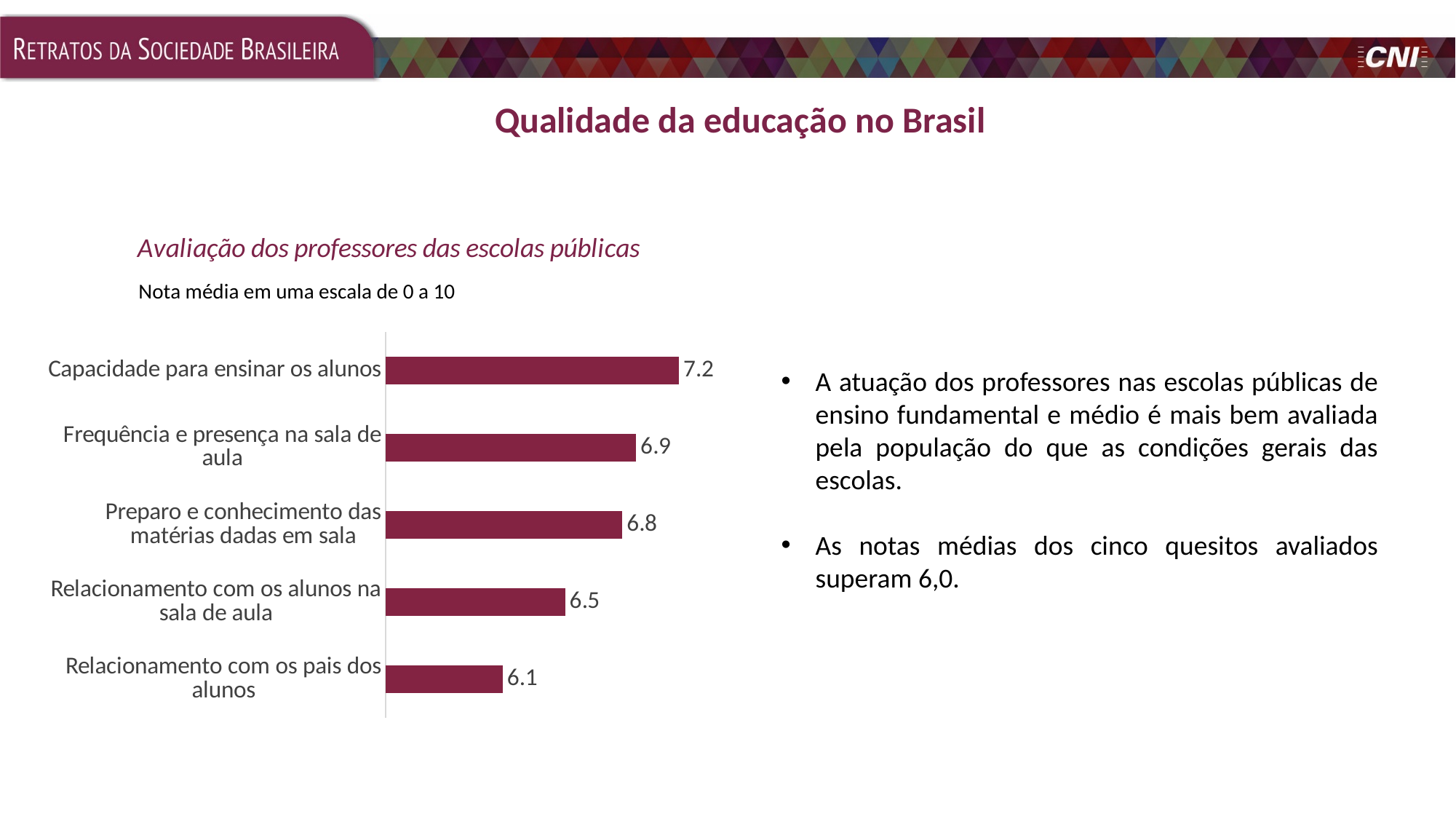
Which category has the lowest average score? Relacionamento com os pais dos alunos What is the average score for "Frequência e presença na sala de aula"? 6.9 How many categories are shown in the chart? 5 What is the difference between the scores for "Capacidade para ensinar os alunos" and "Relacionamento com os pais dos alunos"? 1.1 What is the average score for "Relacionamento com os pais dos alunos"? 6.1 What is the average score for "Relacionamento com os alunos na sala de aula"? 6.5 What is the average score for "Preparo e conhecimento das matérias dadas em sala"? 6.8 What kind of chart is shown on the slide? Bar chart Which category has the highest average score? Capacidade para ensinar os alunos What is the average score for "Capacidade para ensinar os alunos"? 7.2 What is the title of the chart? Avaliação dos professores das escolas públicas Which has a higher score: "Frequência e presença na sala de aula" or "Relacionamento com os alunos na sala de aula"? Frequência e presença na sala de aula